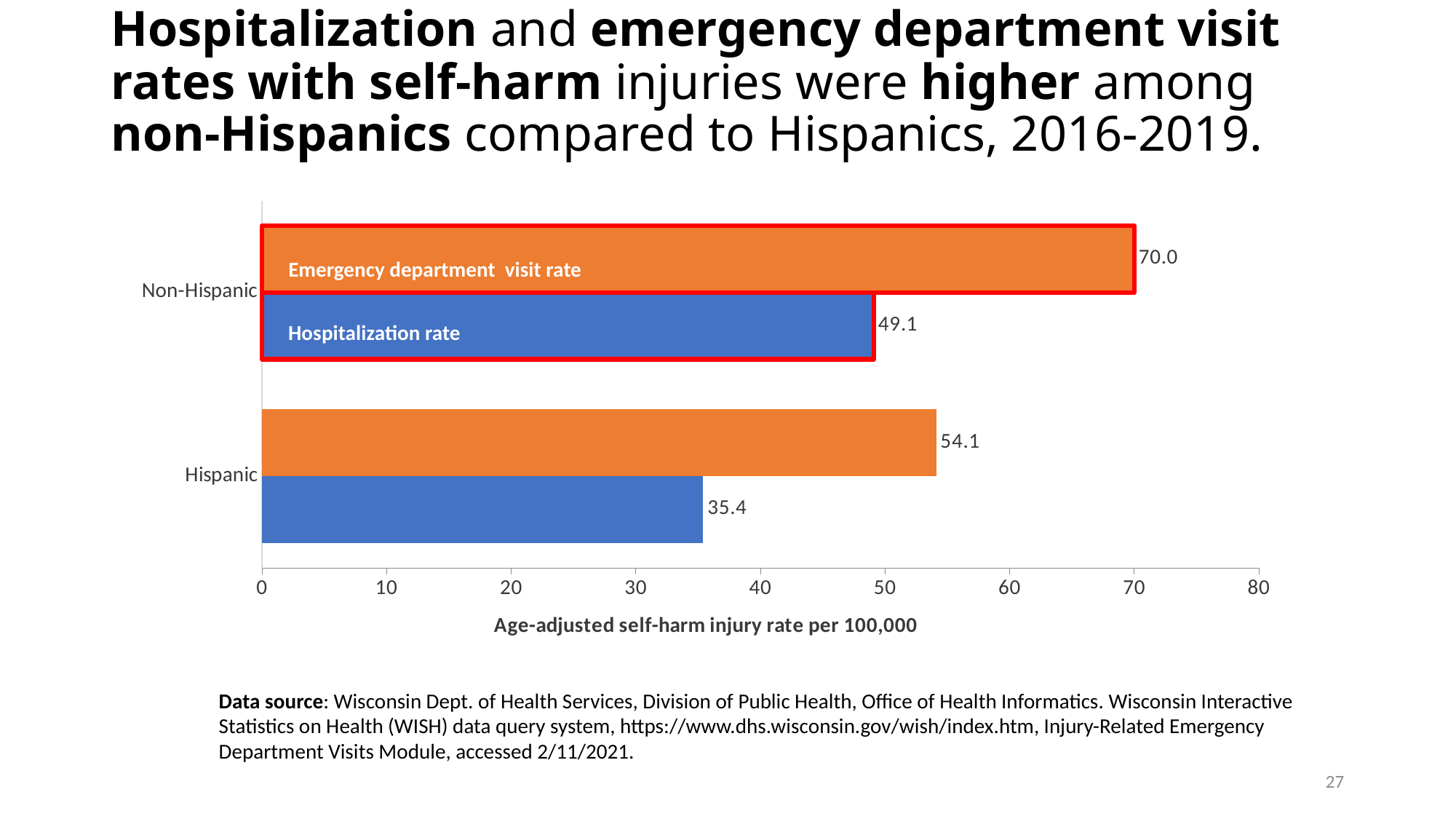
What is the difference between the Non-Hispanic and Hispanic emergency department visit rates? 15.9 What is the hospitalization rate for Non-Hispanics? 49.1 What kind of chart is shown on the slide? bar chart What is the emergency department visit rate for Hispanics? 54.1 What is the label of the x axis? Age-adjusted self-harm injury rate per 100,000 Which group has the higher emergency department visit rate? Non-Hispanic What is the difference between the Non-Hispanic and Hispanic hospitalization rates? 13.7 Is the hospitalization rate for Hispanics larger or smaller than the emergency department visit rate for Hispanics? smaller What is the hospitalization rate for Hispanics? 35.4 What is the emergency department visit rate for Non-Hispanics? 70.0 Which bar shows the lowest value on the chart? Hispanic hospitalization rate How many groups (categories) are shown on the chart? 2